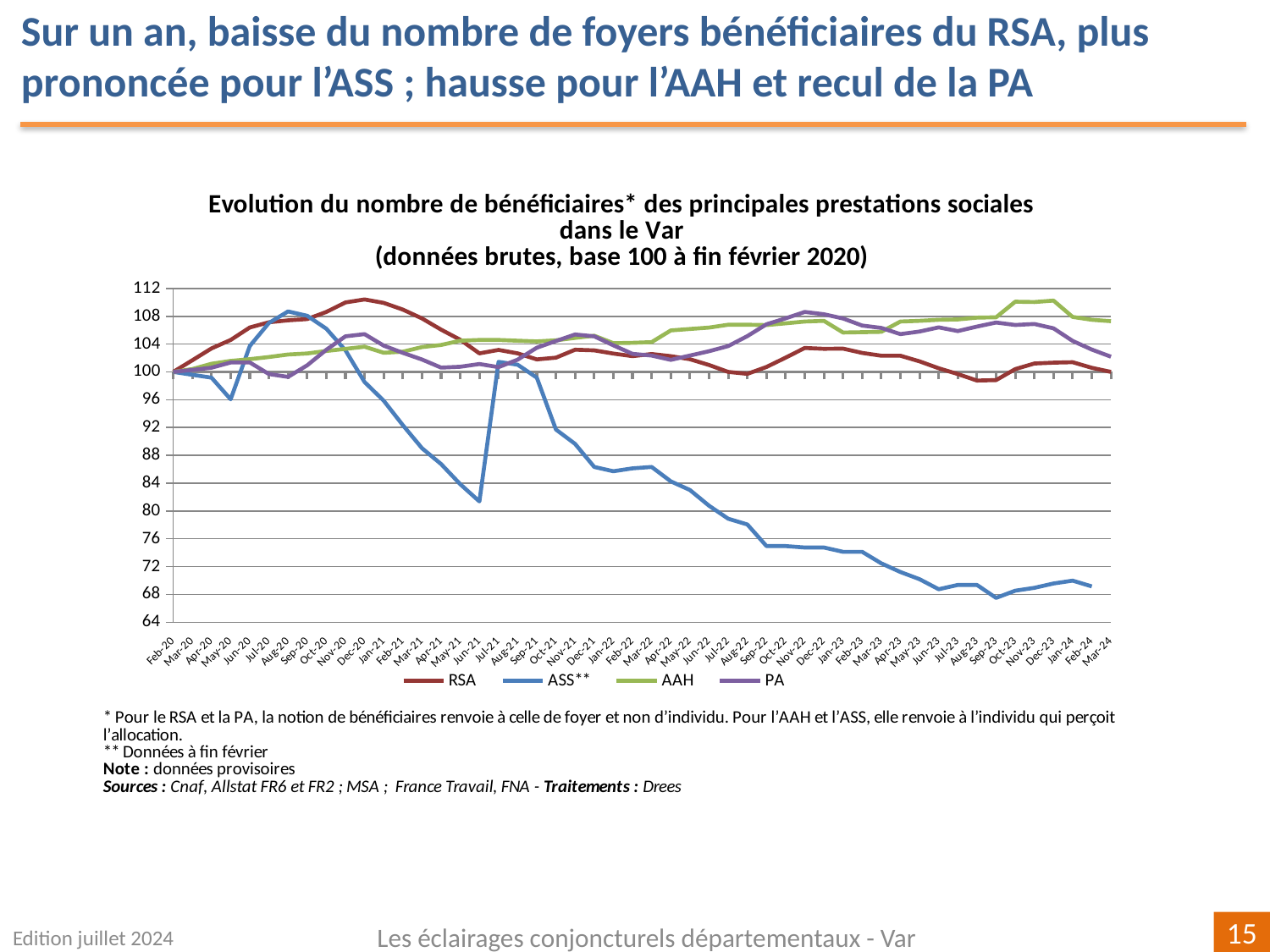
Which series are listed in the legend? RSA, ASS**, AAH, PA Is the value for AAH at Nov-23 greater or less than 108? greater Is the value for RSA at Dec-20 greater or less than 108? greater What is the base value of the index at Feb-20 for all series? 100 Is the value for RSA at Sep-23 greater or less than 100? less Does the ASS** series rise or fall overall from Feb-20 to Mar-24? fall What kind of chart is shown on the slide? line chart Which series has the lowest value at Mar-24? RSA How many series does the legend list? 4 Which series has the highest value at Mar-24? AAH